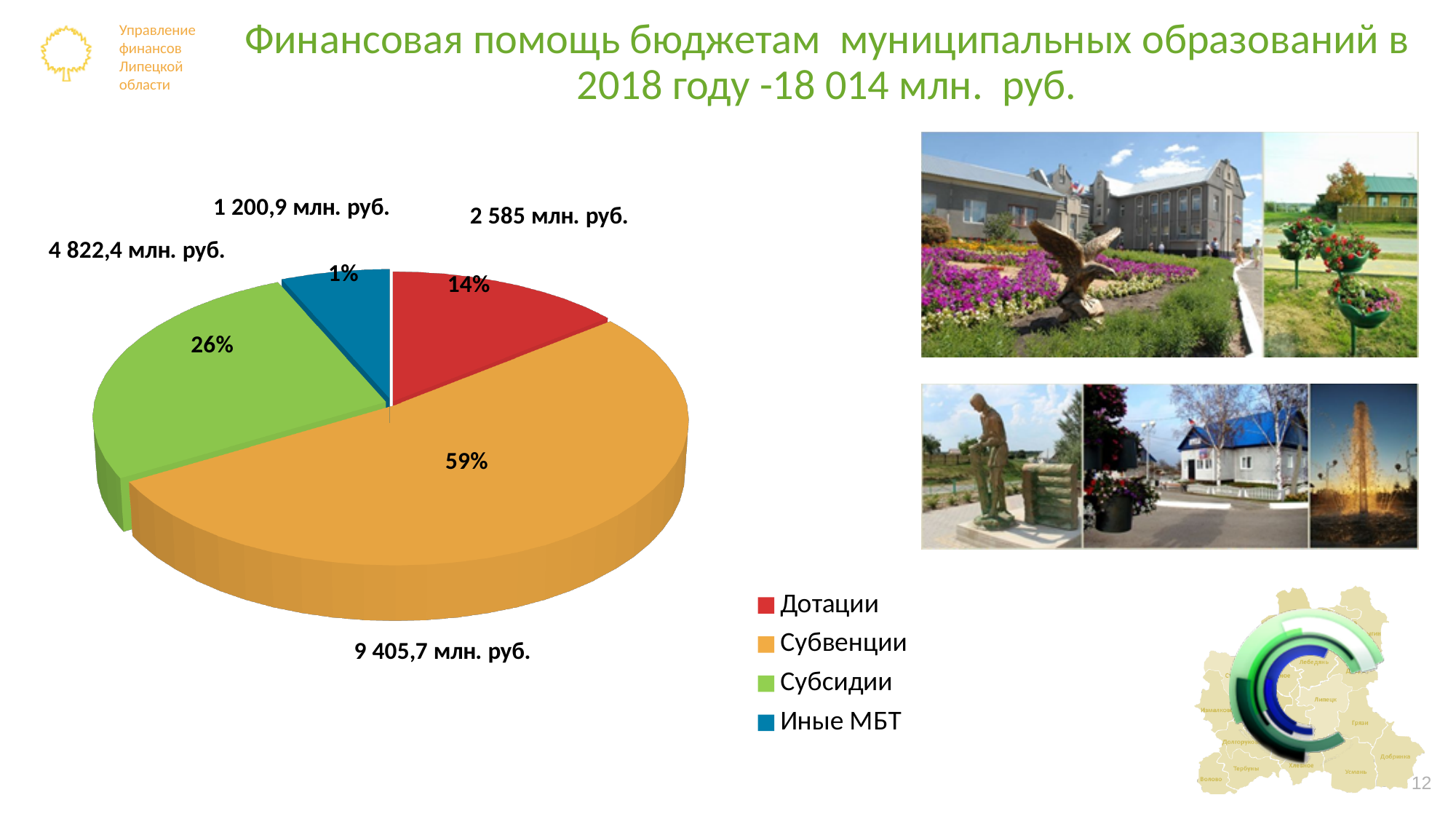
What percentage share of the pie chart is Иные МБТ? 1% What percentage share of the pie chart is Субсидии? 26% Which category has the smallest slice of the pie chart? Иные МБТ What percentage share of the pie chart is Субвенции? 59% How many categories does the legend of the pie chart list? 4 Which category has the largest slice of the pie chart? Субвенции Which slice is larger, Субсидии or Дотации? Субсидии What kind of chart is shown on the slide? pie chart What colour is the Субвенции slice in the pie chart? orange What value in млн. руб. is labelled for the Дотации slice? 2 585 млн. руб. What value in млн. руб. is labelled for the Субвенции slice? 9 405,7 млн. руб.